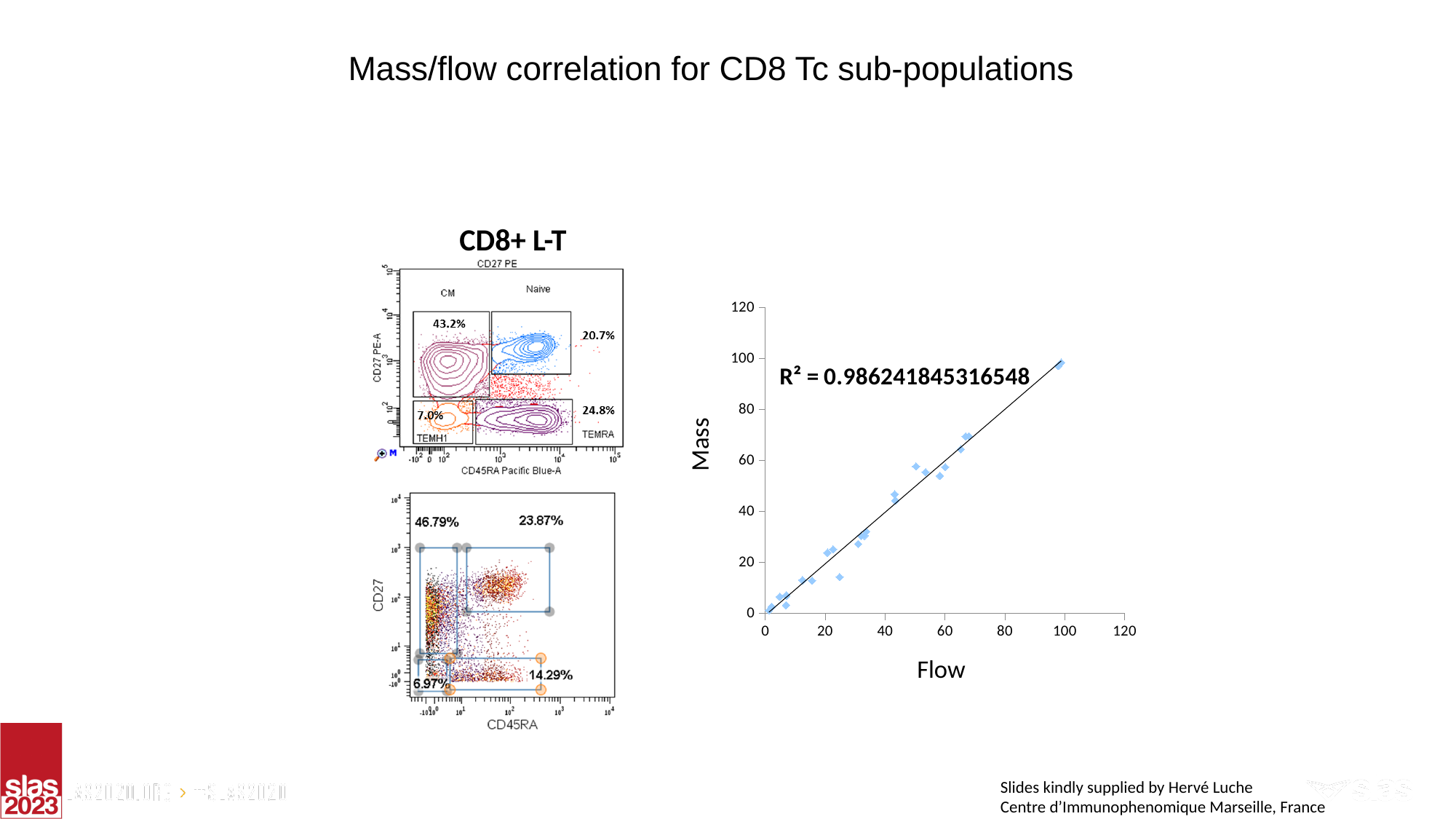
In the CD8+ L-T plot on the left, which is larger, the CM percentage or the Naive percentage? CM What is the label of the vertical axis on the Mass vs Flow scatter chart? Mass In the CD8+ L-T plot on the left, which gate has the lowest percentage? TEMH1 In the lower-left CD27 vs CD45RA plot, what percentage is shown in the upper-left gate? 46.79% In the CD8+ L-T plot on the left, what percentage is shown for the TEMRA gate? 24.8% What kind of chart is the Mass vs Flow chart on the right of the slide? scatter chart In the CD8+ L-T plot on the left, what percentage is shown for the CM gate? 43.2% On the Mass vs Flow scatter chart, do the Mass values rise or fall as Flow increases? rise What is the highest tick value shown on the Flow axis of the scatter chart? 120 What R² value is printed on the Mass vs Flow scatter chart? R² = 0.986241845316548 On the Mass vs Flow scatter chart, is the Mass value of the point with the highest Flow greater or less than 80? greater